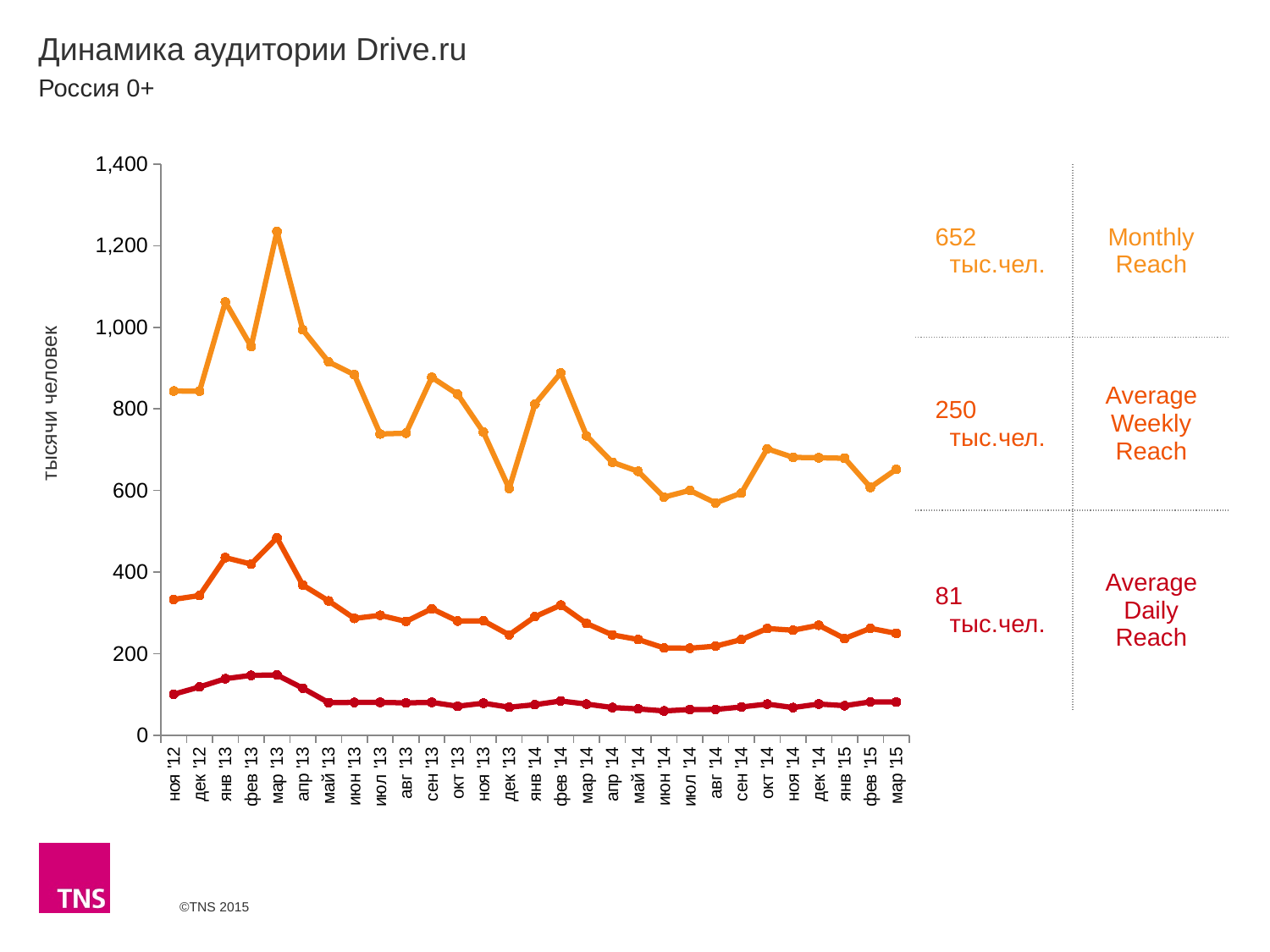
What kind of chart is shown on the slide? line chart Which is higher, Monthly Reach in янв '13 or in фев '13? янв '13 What is the label on the y axis? тысячи человек What is the difference between Monthly Reach and Average Weekly Reach in мар '15? 402 тыс.чел. What is the Monthly Reach value for мар '15? 652 тыс.чел. Is the Monthly Reach value for мар '13 greater or less than 1,200? greater What is the Average Weekly Reach value for мар '15? 250 тыс.чел. In which month does Monthly Reach reach its highest value? мар '13 How many monthly data points are plotted along the x axis? 29 How many series does the chart show? 3 Is the Average Daily Reach value for мар '13 greater or less than 200? less What is the Average Daily Reach value for мар '15? 81 тыс.чел.